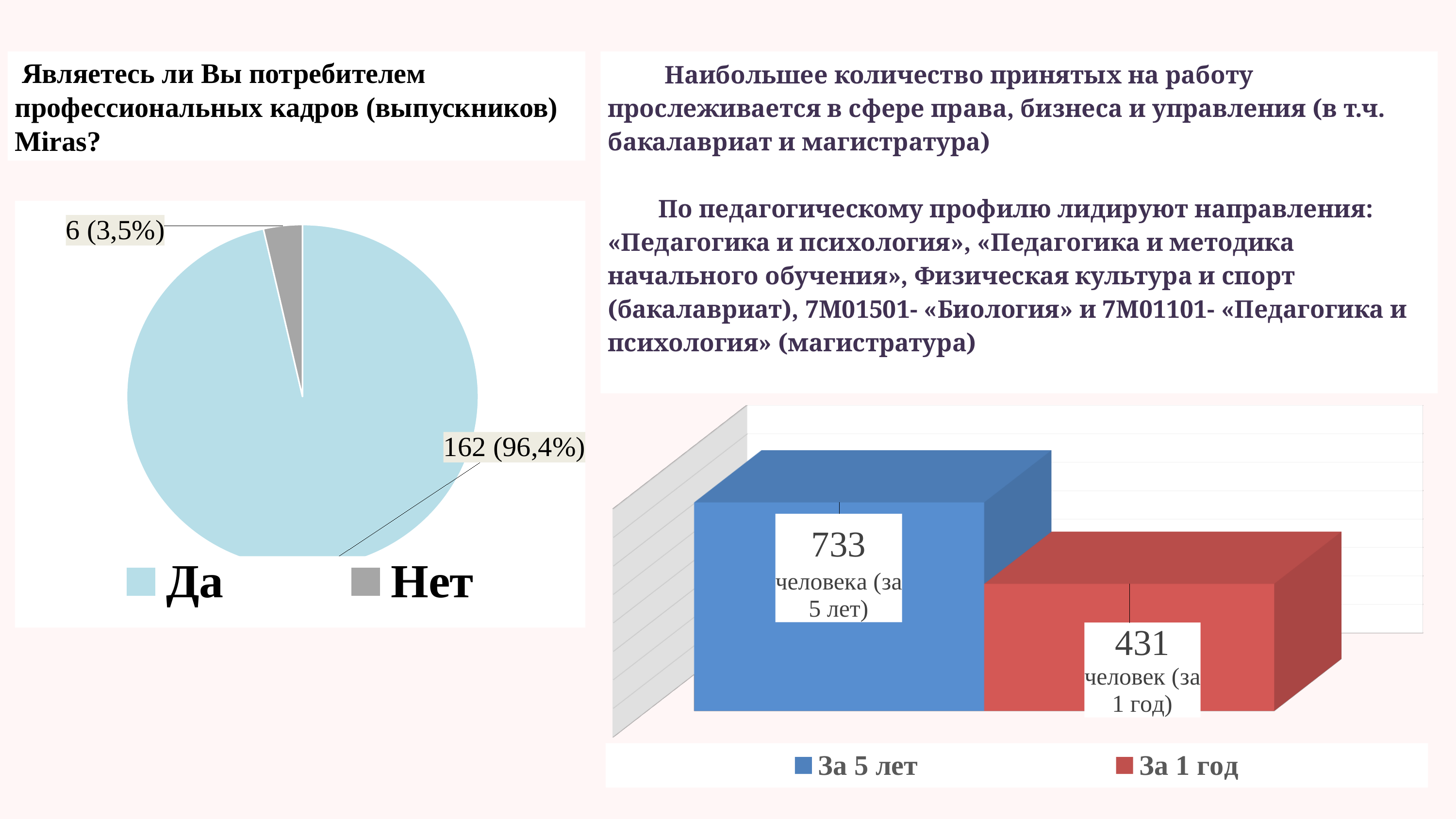
In the bar chart on the right, what value is shown for "За 5 лет"? 733 In the bar chart on the right, how many series does the legend list? 2 In the pie chart on the left, which category is the largest? Да In the pie chart on the left, what share of the pie does "Нет" represent? 3,5% In the bar chart on the right, what value is shown for "За 1 год"? 431 In the bar chart on the right, which is larger: "За 5 лет" or "За 1 год"? За 5 лет What kind of chart is shown on the left side of the slide? Pie chart In the pie chart on the left, what value is shown for "Да"? 162 (96,4%) In the pie chart on the left, how many categories does the legend list? 2 What kind of chart is shown on the right side of the slide? Bar chart In the bar chart on the right, what is the difference between the values for "За 5 лет" and "За 1 год"? 302 In the pie chart on the left, what value is shown for "Нет"? 6 (3,5%)